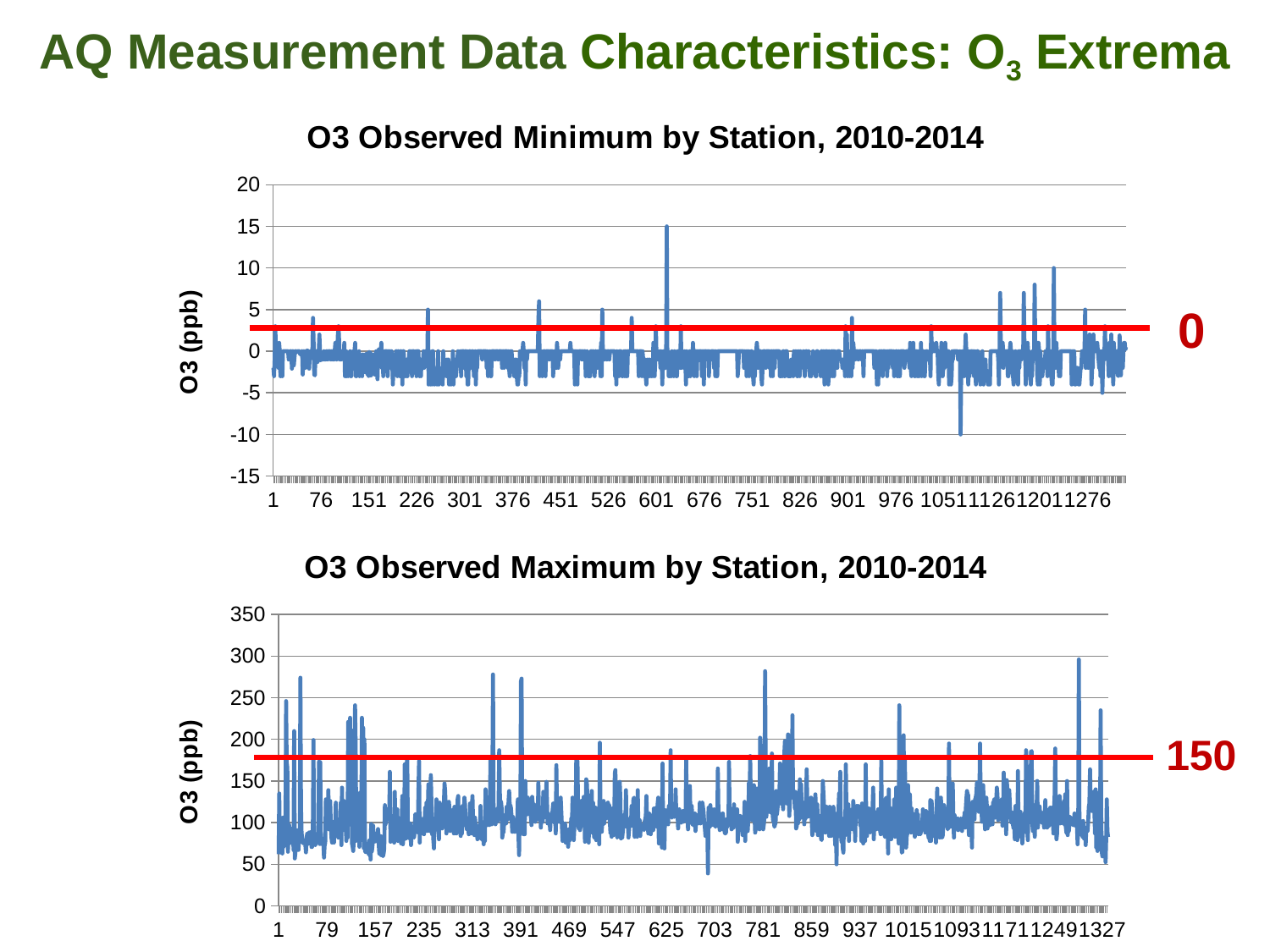
How many charts are shown on the slide? 2 In the top chart, 'O3 Observed Minimum by Station, 2010-2014', is the lowest point of the series greater or less than -5? less What is the title of the bottom chart? O3 Observed Maximum by Station, 2010-2014 In the bottom chart, 'O3 Observed Maximum by Station, 2010-2014', is the lowest point of the series greater or less than 50? less In the bottom chart, 'O3 Observed Maximum by Station, 2010-2014', what number labels the red horizontal line? 150 In the bottom chart, 'O3 Observed Maximum by Station, 2010-2014', what is the last tick label on the x-axis? 1327 In the top chart, 'O3 Observed Minimum by Station, 2010-2014', what is the highest value shown on the y-axis? 20 In the bottom chart, 'O3 Observed Maximum by Station, 2010-2014', is the highest peak of the series greater or less than 250? greater What kind of chart is the top chart, 'O3 Observed Minimum by Station, 2010-2014'? line chart In the bottom chart, 'O3 Observed Maximum by Station, 2010-2014', what is the highest value shown on the y-axis? 350 In the top chart, 'O3 Observed Minimum by Station, 2010-2014', what is the lowest value shown on the y-axis? -15